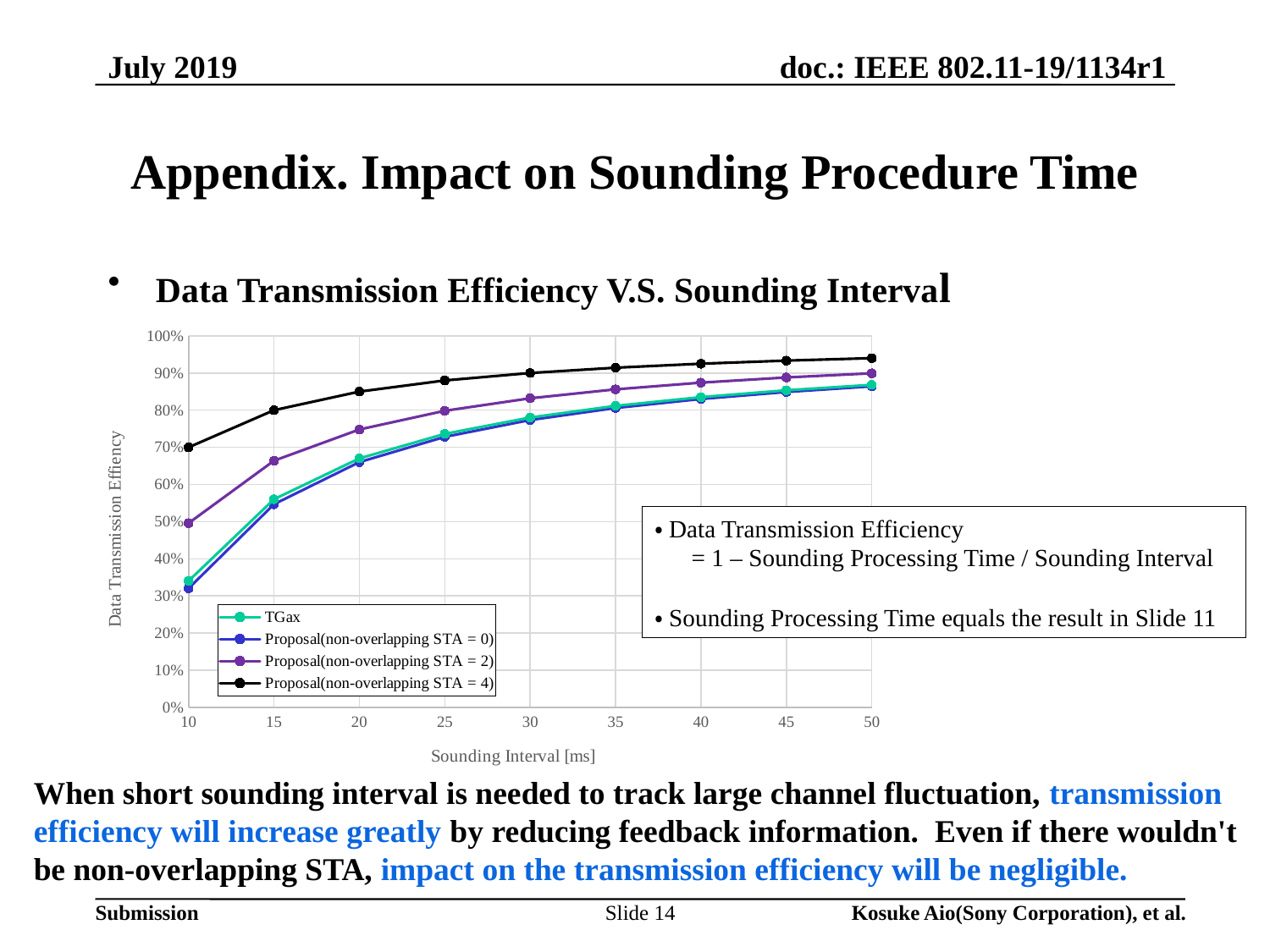
Which series has the highest Data Transmission Efficiency at a Sounding Interval of 50 ms? Proposal(non-overlapping STA = 4) Is the value for Proposal(non-overlapping STA = 2) at a Sounding Interval of 15 ms greater or less than 60%? greater What kind of chart is shown on the slide? line chart Do the Data Transmission Efficiency values rise or fall as the Sounding Interval increases? rise At a Sounding Interval of 10 ms, which is larger: the value for Proposal(non-overlapping STA = 4) or the value for TGax? Proposal(non-overlapping STA = 4) How many sounding interval values are plotted along the x axis? 9 What is the label of the x axis of the chart? Sounding Interval [ms] What colour is the line for Proposal(non-overlapping STA = 4) in the chart? black Is the value for Proposal(non-overlapping STA = 0) at a Sounding Interval of 20 ms greater or less than 60%? greater Is the value for TGax at a Sounding Interval of 50 ms greater or less than 90%? less How many series does the chart legend list? 4